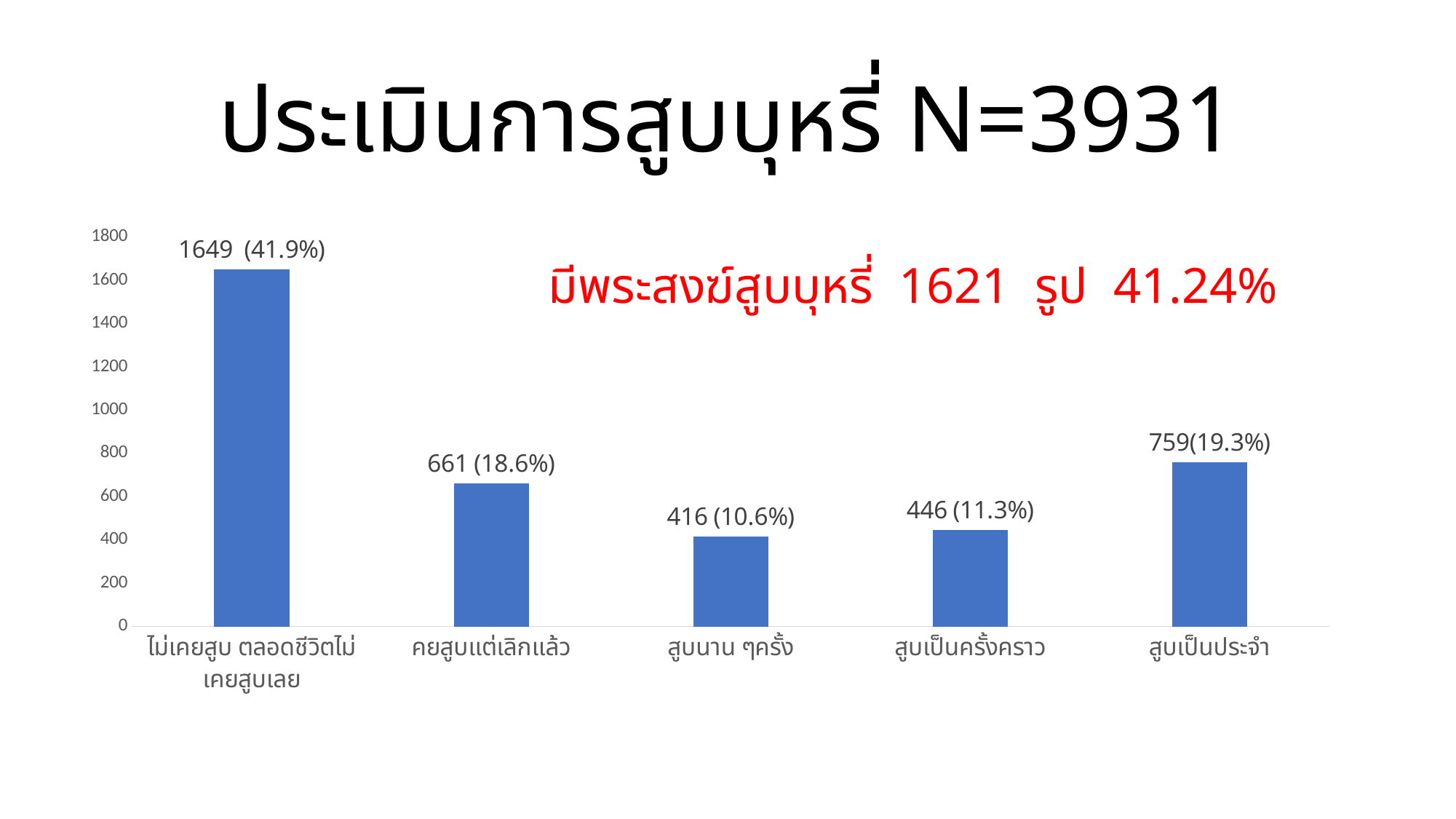
Which is larger, the count for สูบเป็นประจำ or the count for คยสูบแต่เลิกแล้ว? สูบเป็นประจำ What kind of chart is shown on the slide? bar chart What value is shown for the bar labelled ไม่เคยสูบ ตลอดชีวิตไม่เคยสูบเลย? 1649 (41.9%) What value is shown for the bar labelled คยสูบแต่เลิกแล้ว? 661 (18.6%) How many categories are shown on the x axis? 5 Is the value for สูบเป็นครั้งคราว greater or less than 600? less What is the difference in count between ไม่เคยสูบ ตลอดชีวิตไม่เคยสูบเลย and คยสูบแต่เลิกแล้ว? 988 What value is shown for the bar labelled สูบนาน ๆครั้ง? 416 (10.6%) What value is shown for the bar labelled สูบเป็นประจำ? 759(19.3%) Which category has the highest bar? ไม่เคยสูบ ตลอดชีวิตไม่เคยสูบเลย Which category has the lowest bar? สูบนาน ๆครั้ง What is the difference in count between สูบเป็นประจำ and สูบเป็นครั้งคราว? 313